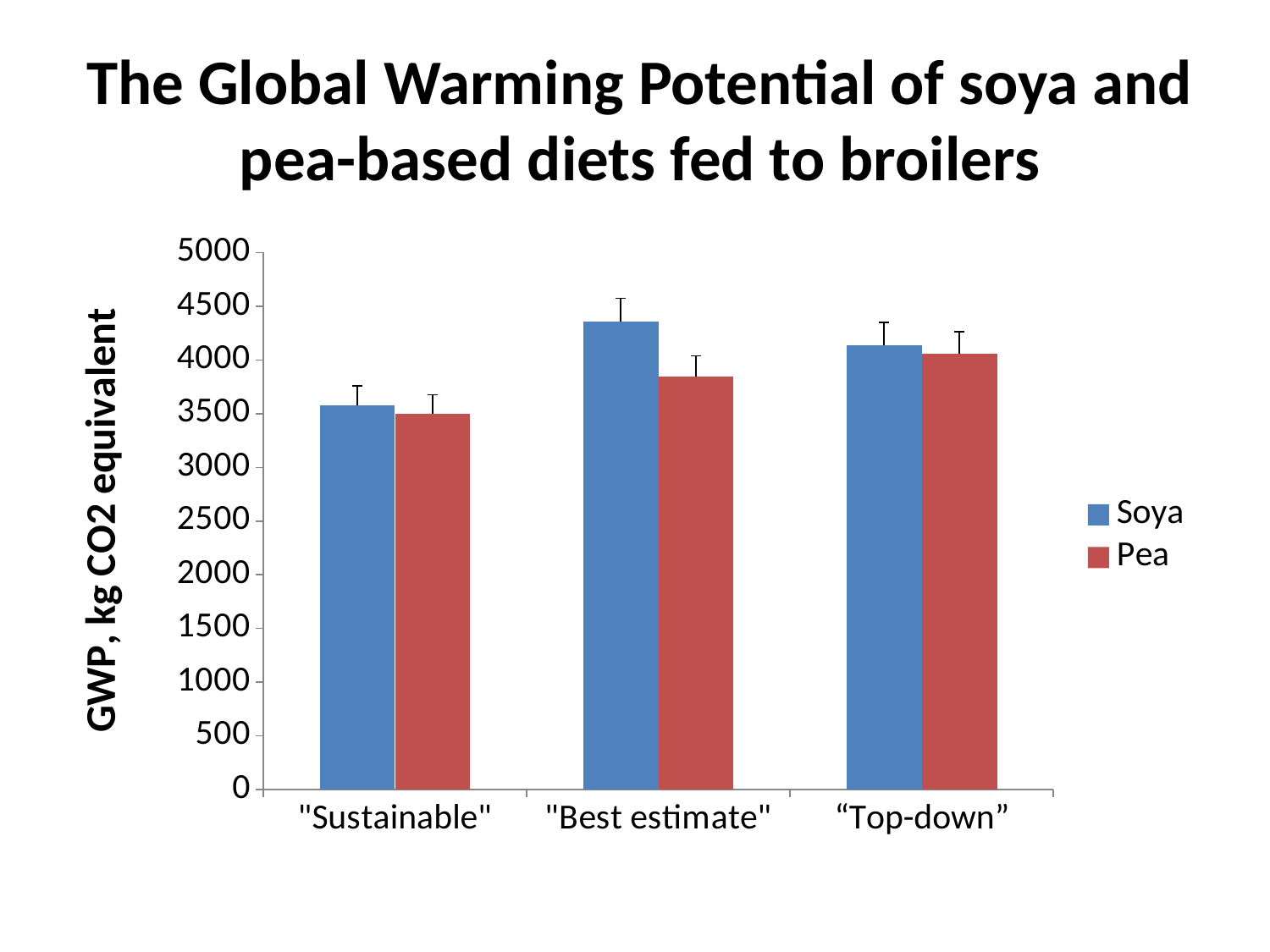
How many series does the legend list? 2 Which colour represents the Pea series in the legend? red What is the label of the y axis? GWP, kg CO2 equivalent Is the Soya value for "Best estimate" greater or less than 4000? greater In the "Best estimate" category, which is larger, the Soya value or the Pea value? Soya Which category has the highest Soya value? "Best estimate" Is the Pea value for "Best estimate" greater or less than 3500? greater What kind of chart is shown on the slide? bar chart Which category has the lowest Pea value? "Sustainable" Is the Soya value for "Sustainable" greater or less than 3000? greater How many categories are shown on the x axis? 3